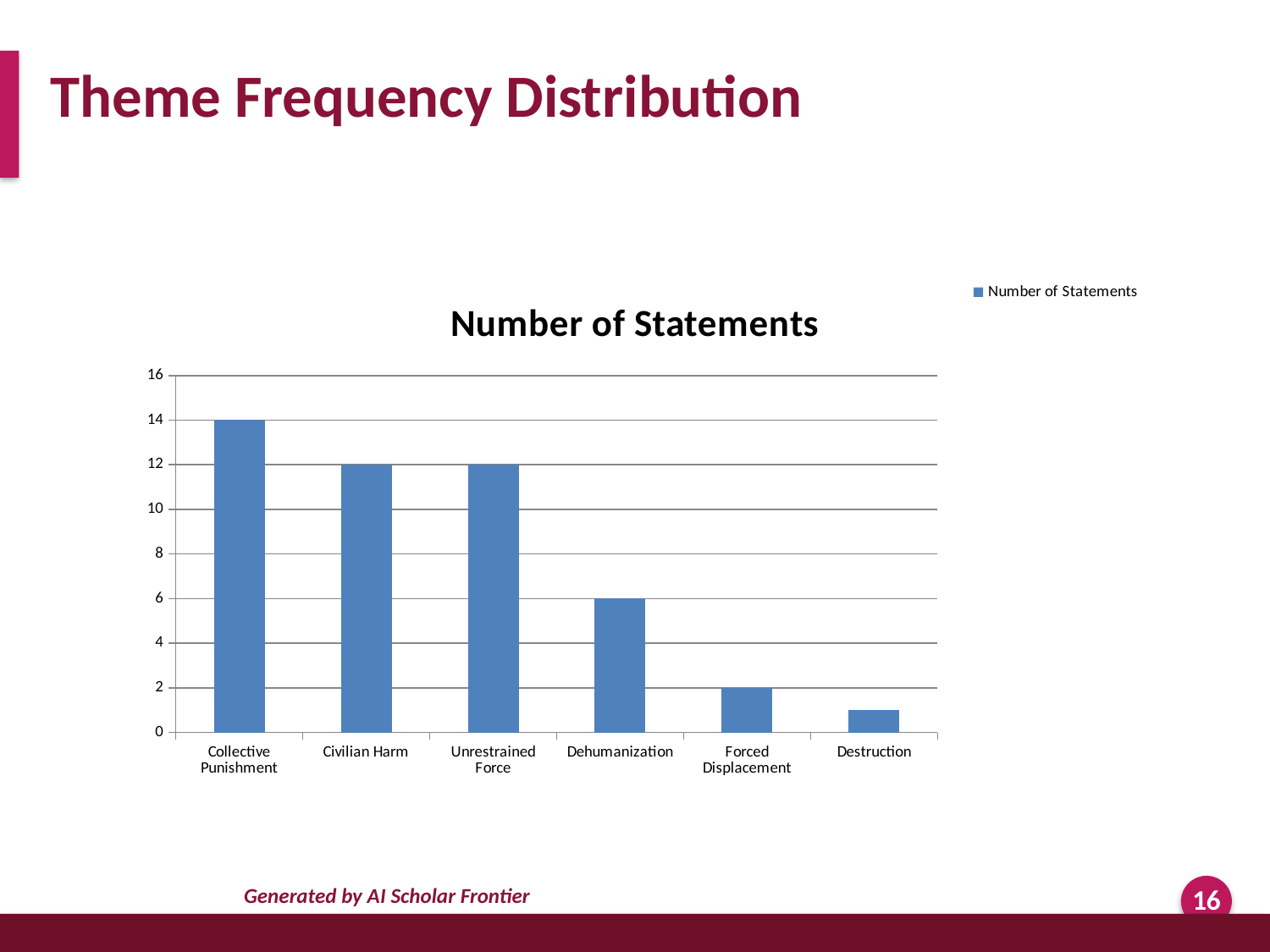
Which theme has the highest number of statements? Collective Punishment What is the number of statements for Collective Punishment? 14 Which theme has the lowest number of statements? Destruction What is the number of statements for Civilian Harm? 12 Is the value for Destruction greater or less than 2? less Do the values rise or fall moving from left to right along the x axis? Fall How many categories are shown on the x axis of the chart? 6 What is the number of statements for Forced Displacement? 2 What is the number of statements for Dehumanization? 6 What type of chart is shown on the slide? Bar chart What is the difference in number of statements between Collective Punishment and Dehumanization? 8 How many series does the legend list? 1